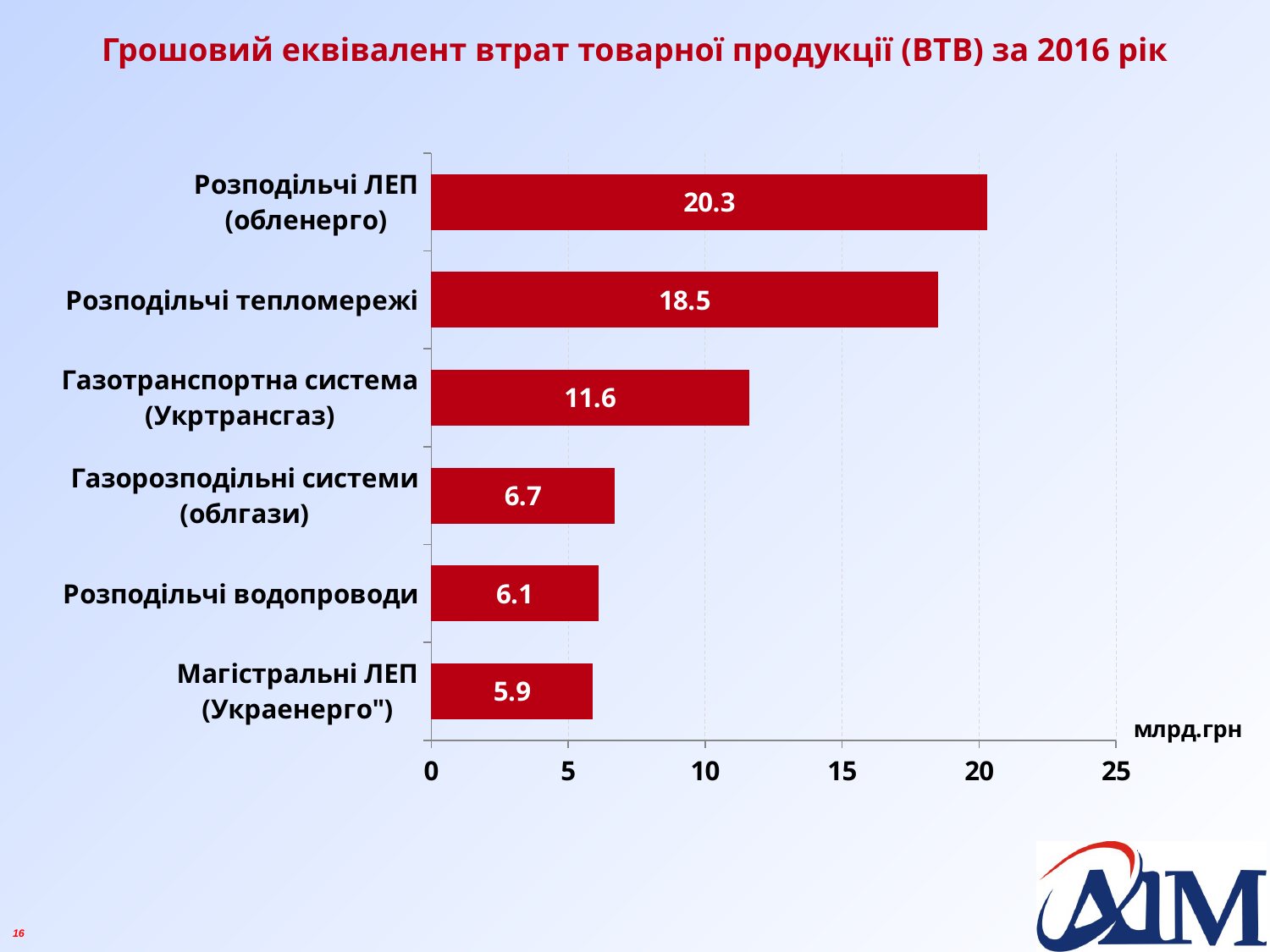
What is the difference between the values for Розподільчі ЛЕП (обленерго) and Розподільчі тепломережі? 1.8 What is the difference between the values for Газотранспортна система (Укртрансгаз) and Газорозподільні системи (облгази)? 4.9 What unit is shown next to the horizontal axis? млрд.грн What kind of chart is shown on the slide? bar chart How many categories are shown in the chart? 6 What is the value for Розподільчі водопроводи? 6.1 Which category has the lowest value? Магістральні ЛЕП (Украенерго") Is the value for Розподільчі тепломережі greater or less than 15? greater Which category has the highest value? Розподільчі ЛЕП (обленерго) What is the value for Газотранспортна система (Укртрансгаз)? 11.6 Which is larger, the value for Розподільчі тепломережі or the value for Газотранспортна система (Укртрансгаз)? Розподільчі тепломережі What is the value for Розподільчі ЛЕП (обленерго)? 20.3